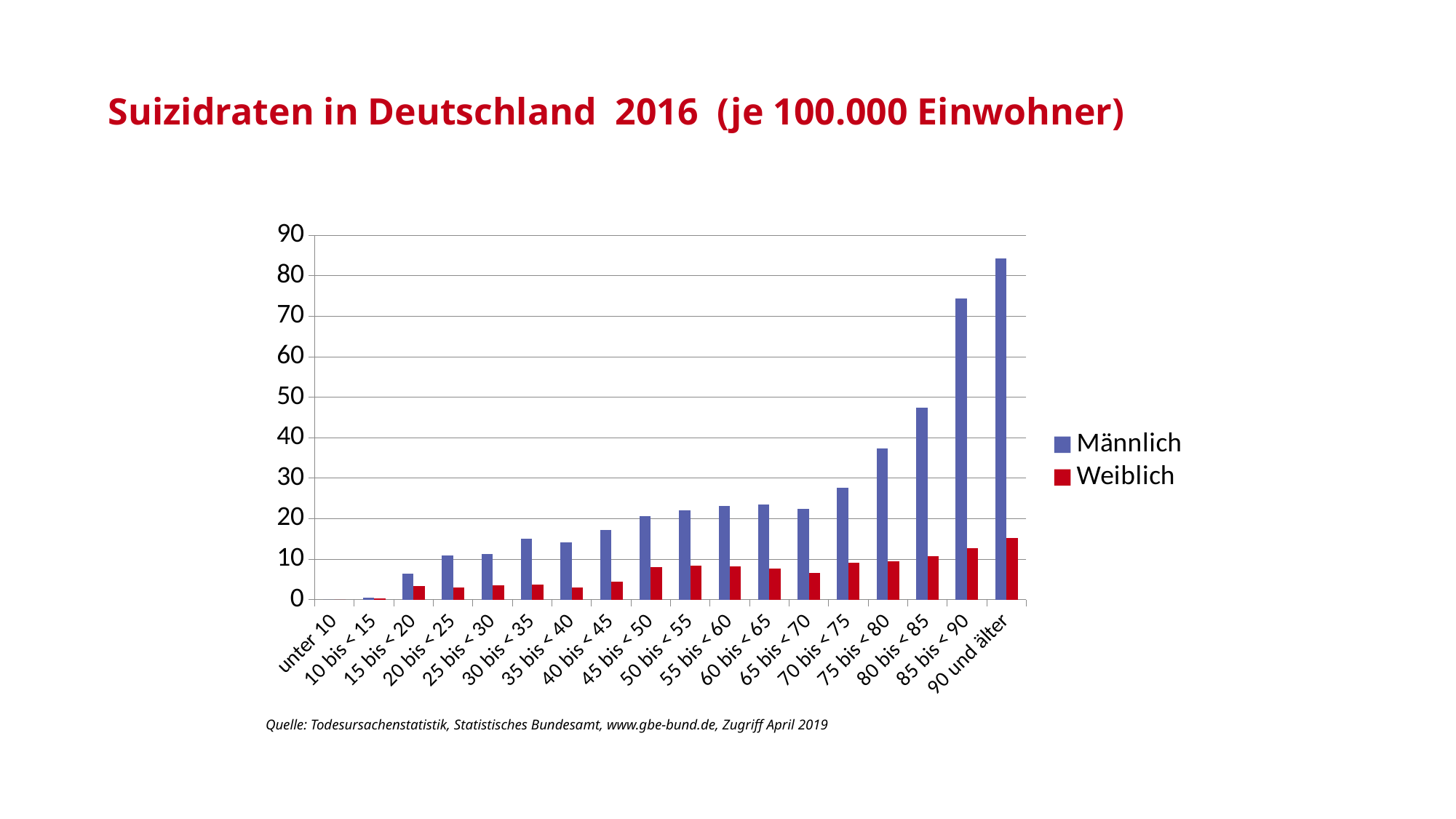
Is the Männlich value for 90 und älter greater or less than 80? greater Is the Männlich value for 80 bis < 85 greater or less than 50? less What is the title of the chart? Suizidraten in Deutschland 2016 (je 100.000 Einwohner) For the age group 90 und älter, which series has the larger value, Männlich or Weiblich? Männlich Is the Männlich value for 15 bis < 20 greater or less than 10? less Which age group has the highest value for Männlich? 90 und älter How many series does the legend list? 2 How many age groups are shown on the x axis? 18 What kind of chart is shown on the slide? bar chart Which age group has the highest value for Weiblich? 90 und älter Which age group has the lowest value for Männlich? unter 10